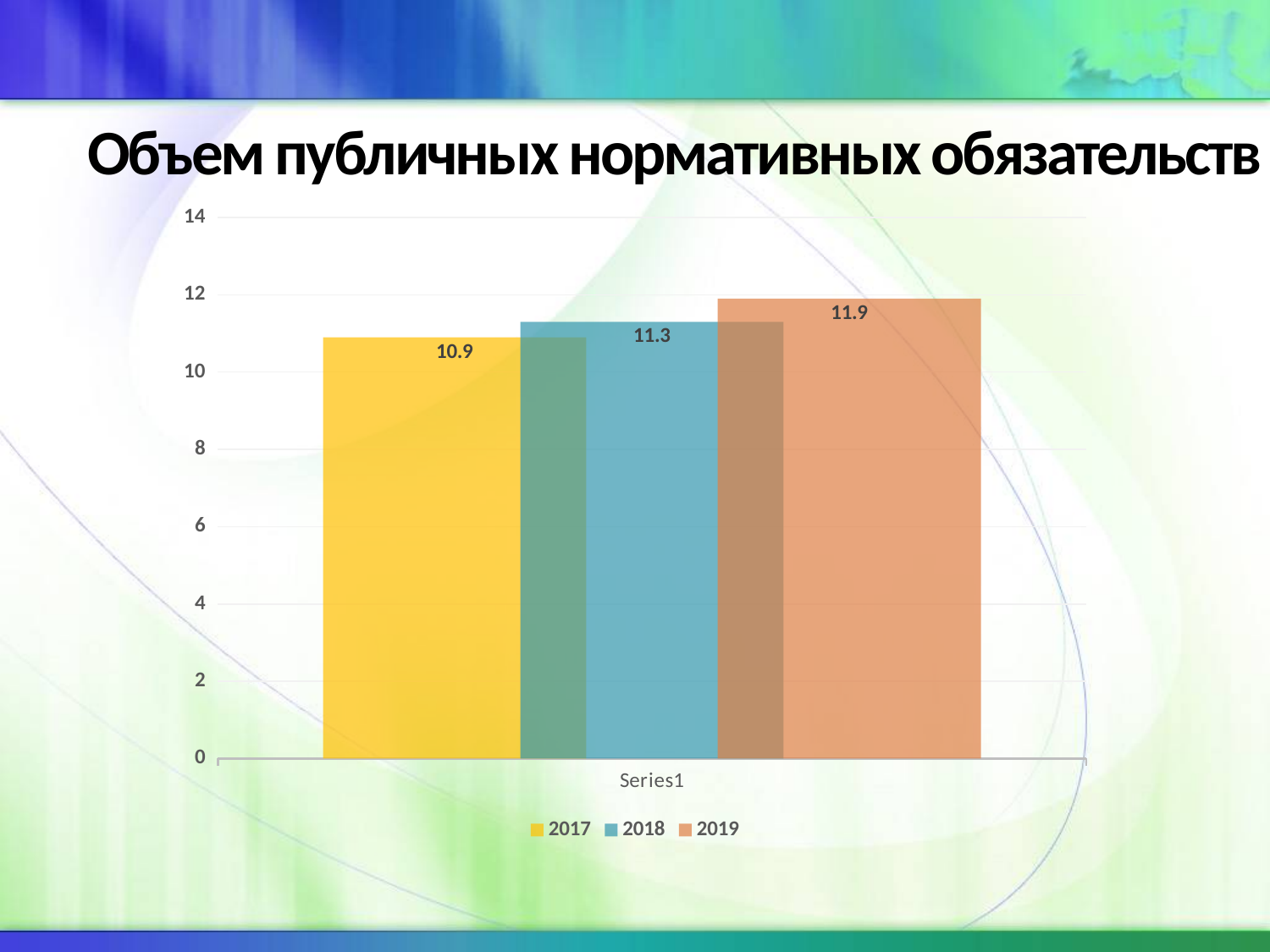
Which year has the highest value? 2019 Which is larger, the value for 2018 or the value for 2019? 2019 What is the value for 2018? 11.3 What is the difference between the values for 2018 and 2017? 0.4 What is the difference between the values for 2019 and 2017? 1.0 How many series does the legend list? 3 What is the title of the chart? Объем публичных нормативных обязательств Which year has the lowest value? 2017 What is the value for 2019? 11.9 What kind of chart is shown on the slide? bar chart What is the value for 2017? 10.9 Is the value for 2019 greater or less than 10? greater